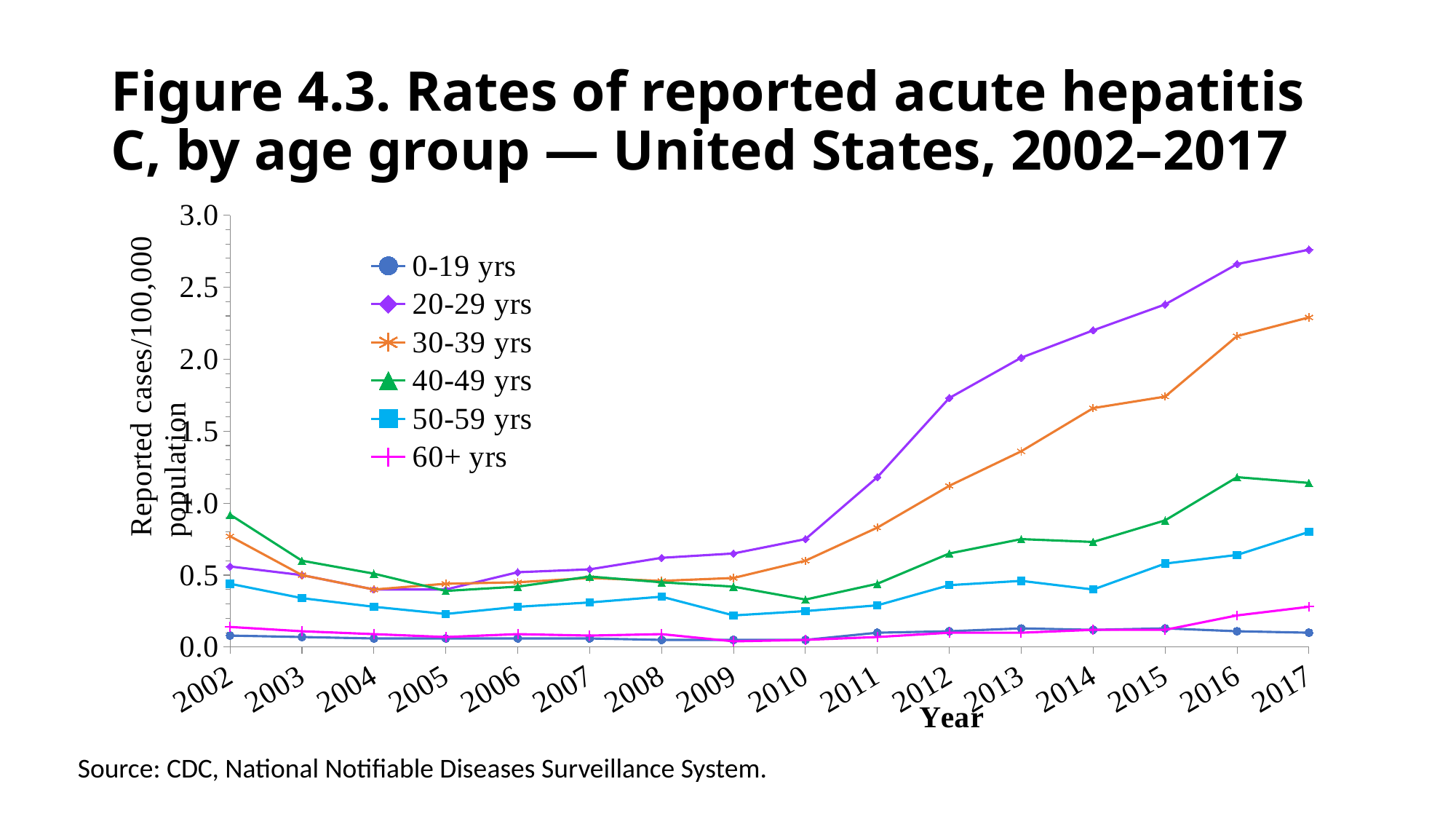
How many age groups does the legend list? 6 Is the value for 20-29 yrs in 2017 greater or less than 2.5? greater What kind of chart is shown on the slide? line chart What is the title of the x axis? Year Does the rate for 20-29 yrs rise or fall from 2010 to 2017? rise Which age group has the highest rate in 2002? 40-49 yrs In 2017, which is larger: the rate for 40-49 yrs or the rate for 50-59 yrs? 40-49 yrs How many years are shown along the x axis? 16 Which age group has the lowest rate in 2017? 0-19 yrs Is the value for 30-39 yrs in 2017 greater or less than 2.0? greater Is the value for 50-59 yrs in 2017 greater or less than 1.0? less Which age group has the highest rate in 2017? 20-29 yrs